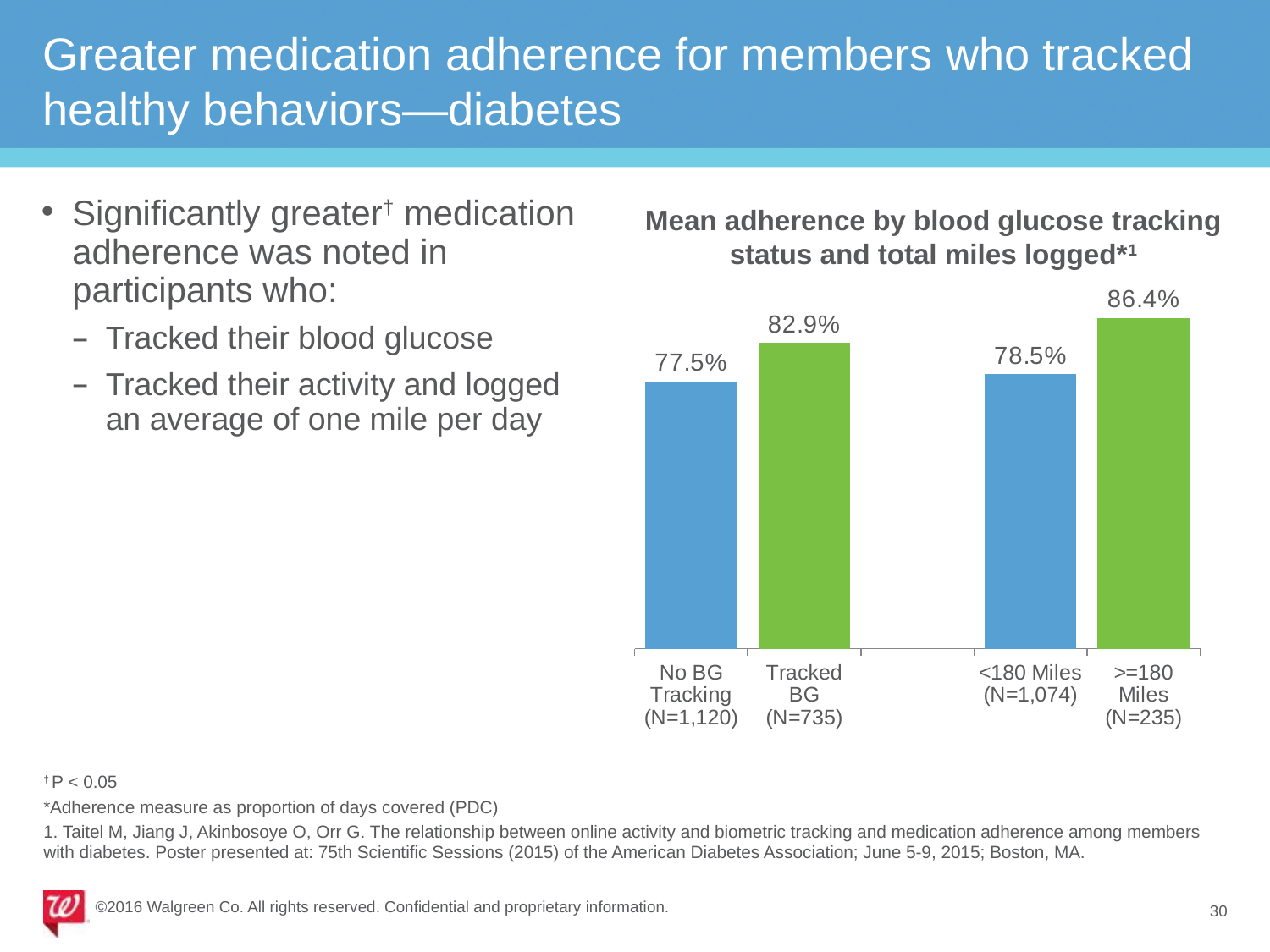
What is the mean adherence for the Tracked BG group? 82.9% What is the sample size (N) for the Tracked BG group? 735 Which group has the highest mean adherence? >=180 Miles How many bars are shown in the chart? 4 What type of chart is shown on the slide? Bar chart Which has higher mean adherence, Tracked BG or <180 Miles? Tracked BG What is the mean adherence for the >=180 Miles group? 86.4% What is the difference in mean adherence between the >=180 Miles and <180 Miles groups? 7.9% What is the mean adherence for the No BG Tracking group? 77.5% Which group has the lowest mean adherence? No BG Tracking What is the difference in mean adherence between the Tracked BG and No BG Tracking groups? 5.4% What is the mean adherence for the <180 Miles group? 78.5%